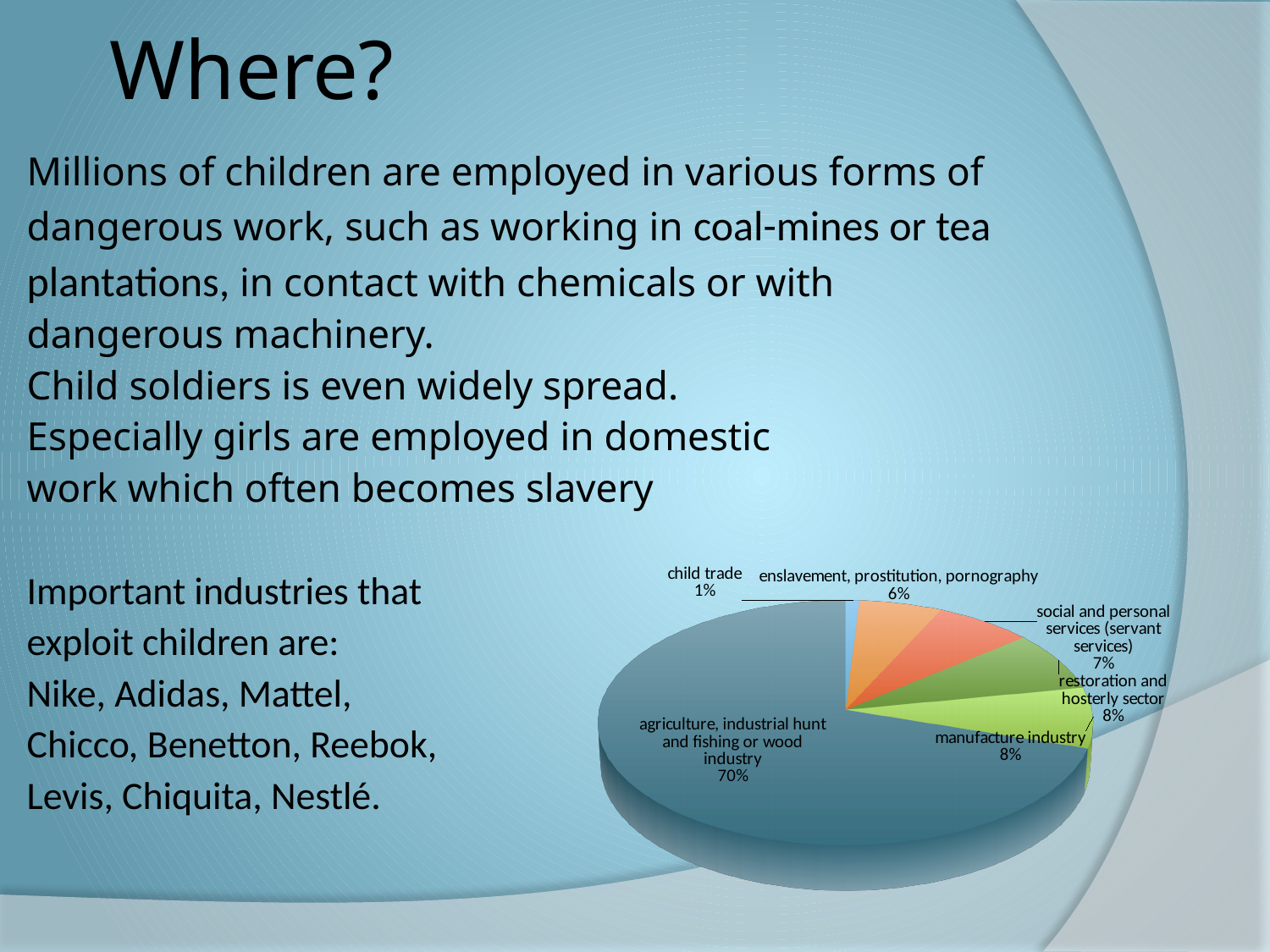
What share of the pie is labelled "child trade"? 1% What share of the pie is labelled "agriculture, industrial hunt and fishing or wood industry"? 70% What share of the pie is labelled "social and personal services (servant services)"? 7% Which category has the largest slice of the pie? agriculture, industrial hunt and fishing or wood industry What kind of chart is shown on the slide? pie chart Which category has the smallest slice of the pie? child trade What is the difference in percentage points between the "agriculture, industrial hunt and fishing or wood industry" slice and the "manufacture industry" slice? 62 What is the difference in percentage points between the "restoration and hosterly sector" slice and the "child trade" slice? 7 How many slices does the pie chart have? 6 Which is larger: the "social and personal services (servant services)" slice or the "enslavement, prostitution, pornography" slice? social and personal services (servant services)